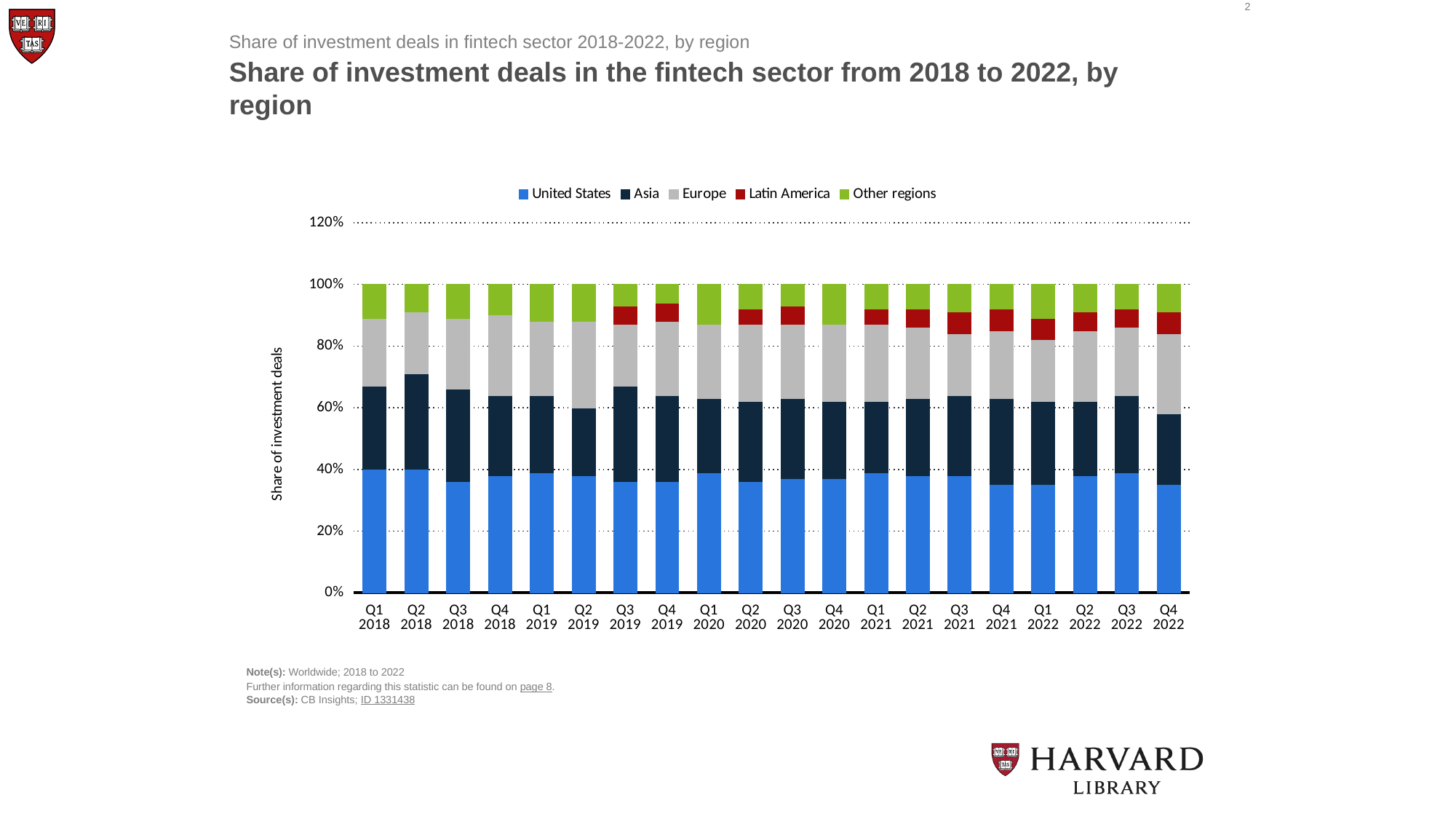
Which regions are listed in the legend? United States, Asia, Europe, Latin America, Other regions In Q2 2018, is the top of the Asia segment greater or less than 60%? greater Is the United States share in Q1 2018 greater or less than 20%? greater Is the United States share in Q4 2022 greater or less than 40%? less Which is larger, the United States share in Q2 2018 or in Q3 2018? Q2 2018 In which quarter does the Latin America segment first appear in the bars? Q3 2019 What kind of chart is shown on the slide? Stacked bar chart What is the total of the stacked bar for Q1 2020? 100% How many quarters are plotted along the x axis? 20 How many series does the legend list? 5